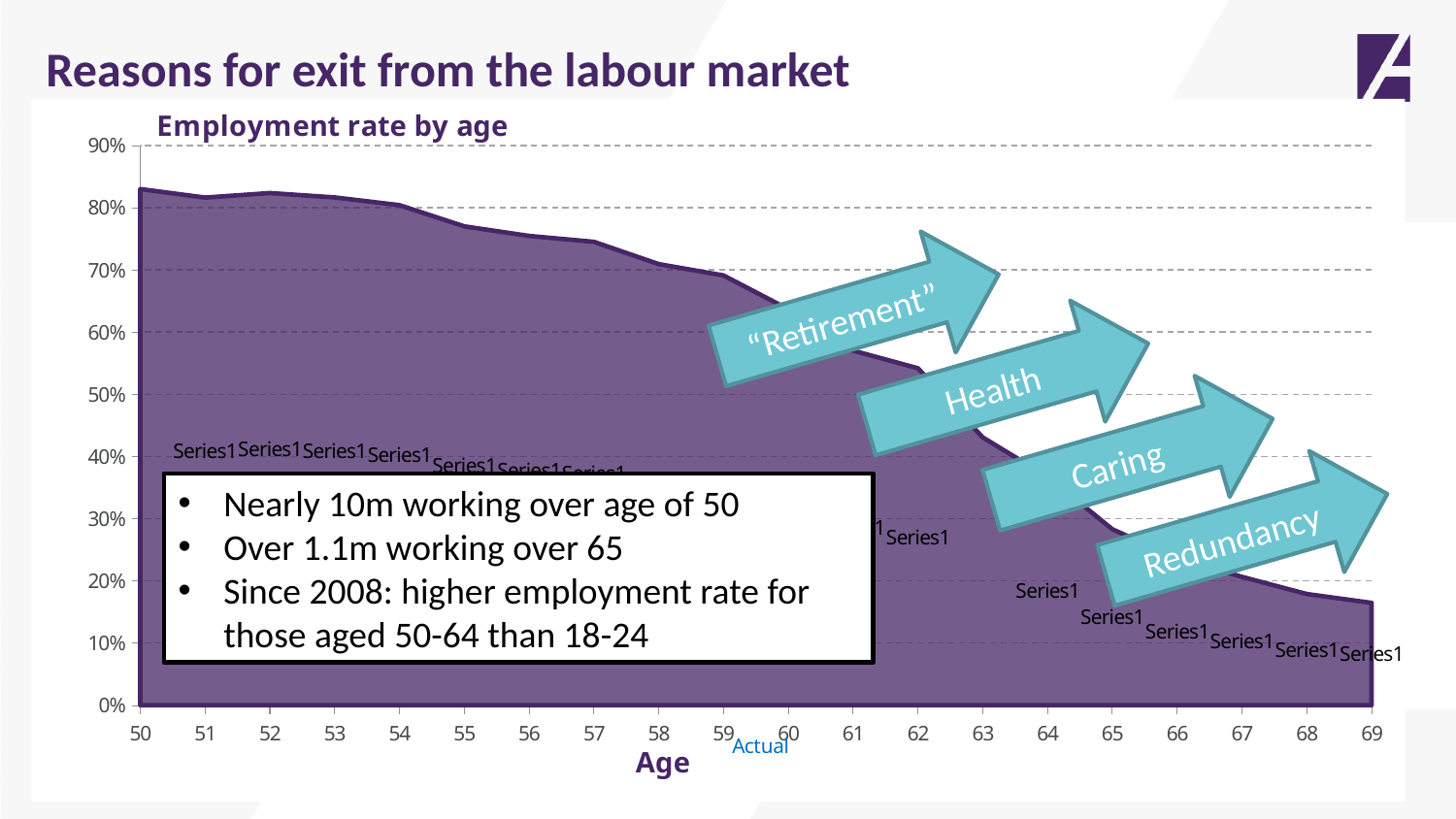
Which age has the lowest employment rate? 69 Is the employment rate at age 65 greater or less than 40%? less Does the employment rate rise or fall as age increases from 50 to 69? fall What is the title of the chart? Employment rate by age Which age has a higher employment rate, 52 or 66? 52 Which age has the highest employment rate? 50 How many ages are plotted along the x axis? 20 What kind of chart is shown on the slide? area chart Is the employment rate at age 50 greater or less than 80%? greater What is the label of the x axis? Age Is the employment rate at age 69 greater or less than 20%? less